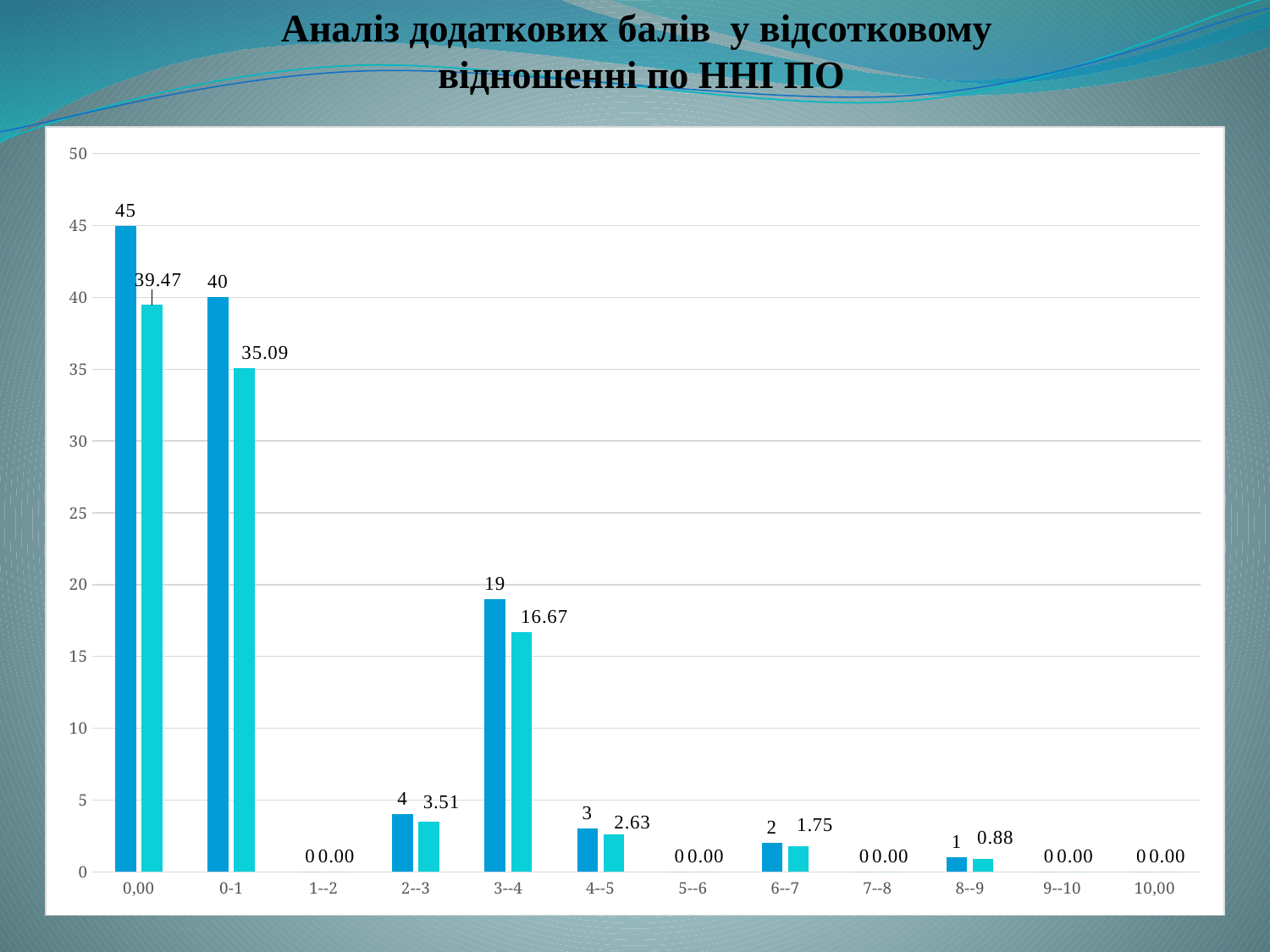
Is the lighter cyan bar for the category 0,00 greater or less than 35? greater Which category has the highest darker blue bar? 0,00 How many categories are shown on the x axis of the chart? 12 What is the difference between the darker blue bar values for 0,00 and 0-1? 5 What is the title of the slide? Аналіз додаткових балів у відсотковому відношенні по ННІ ПО What is the value of the lighter cyan bar for the category 0-1? 35.09 What type of chart is shown on the slide? bar chart What is the value of the lighter cyan bar for the category 8--9? 0.88 What is the value of the darker blue bar for the category 0,00? 45 Which is larger: the darker blue bar for 2--3 or the darker blue bar for 4--5? 2--3 What is the value of the lighter cyan bar for the category 3--4? 16.67 What is the value of the darker blue bar for the category 6--7? 2